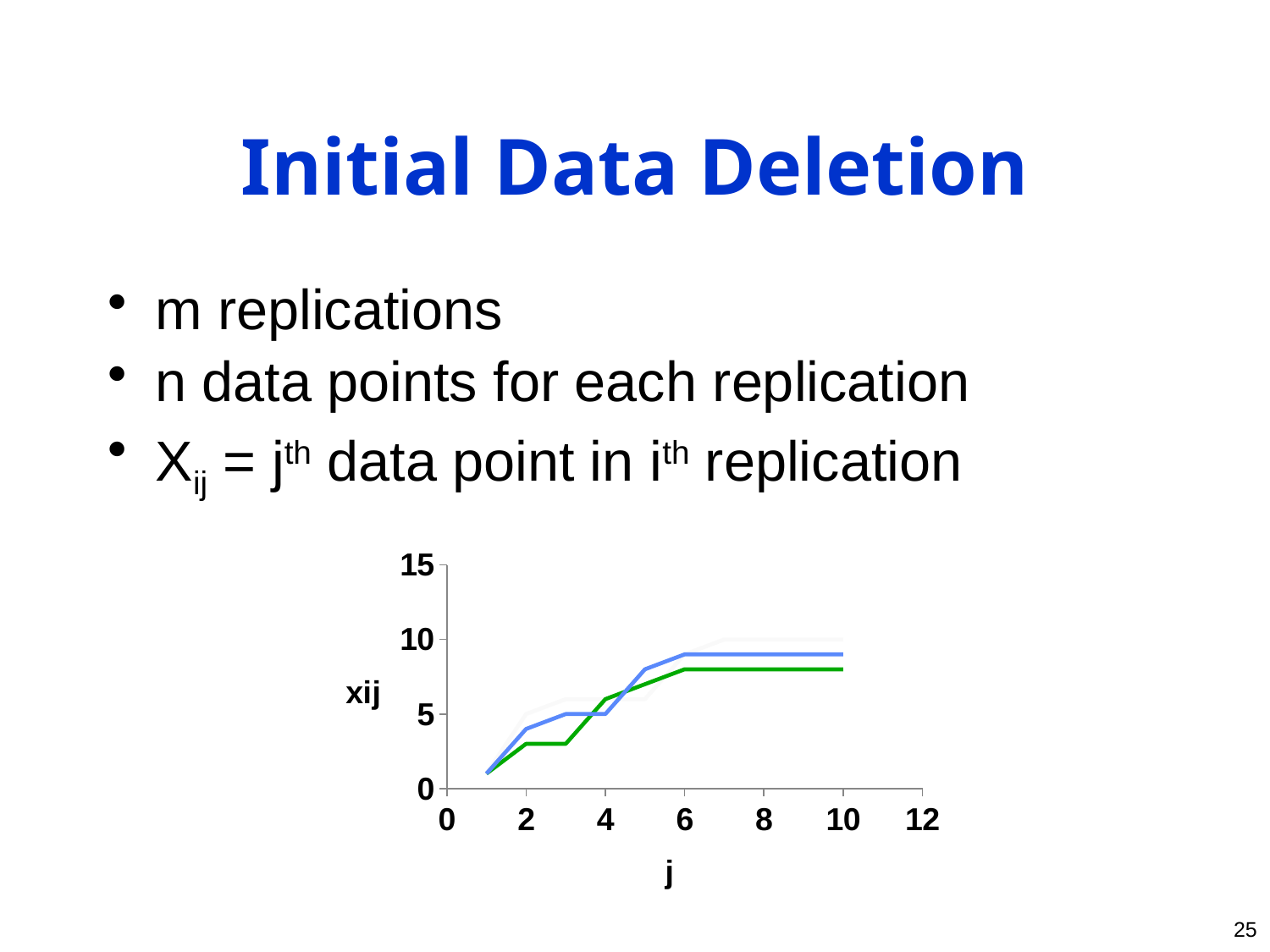
Do the plotted values generally rise or fall as j increases? rise What kind of chart is shown on the slide? line chart Is the value of the green line at j = 10 greater or less than 10? less Is the value of the blue line at j = 10 greater or less than 5? greater Is the value of the green line at j = 10 greater or less than 5? greater What is the label of the y axis of the chart? xij At j = 10, which line has the higher value, the blue line or the green line? blue line What is the label of the x axis of the chart? j